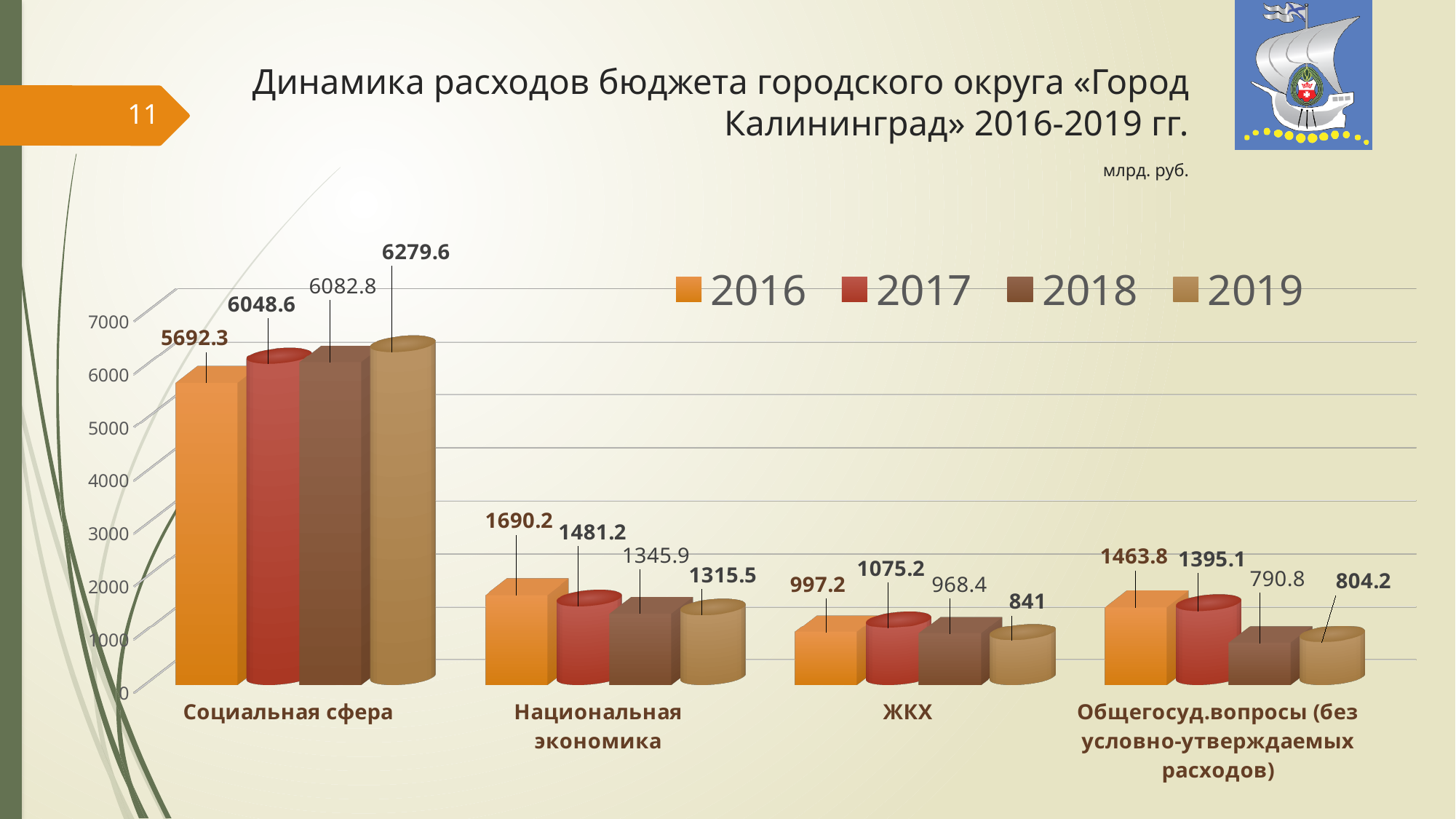
Which is larger for ЖКХ: the 2016 value or the 2017 value? 2017 Do the values for Национальная экономика rise or fall from 2016 to 2019? Fall How many series does the legend list? 4 What kind of chart is shown on the slide? Bar chart Which category has the lowest value in 2019? Общегосуд.вопросы (без условно-утверждаемых расходов) Which category has the highest value in 2016? Социальная сфера What is the value for Социальная сфера in 2019? 6279.6 What is the value for ЖКХ in 2017? 1075.2 What is the difference between the 2019 and 2016 values for Социальная сфера? 587.3 What is the value for Национальная экономика in 2016? 1690.2 How many categories are shown on the x axis? 4 What is the value for Общегосуд.вопросы (без условно-утверждаемых расходов) in 2018? 790.8